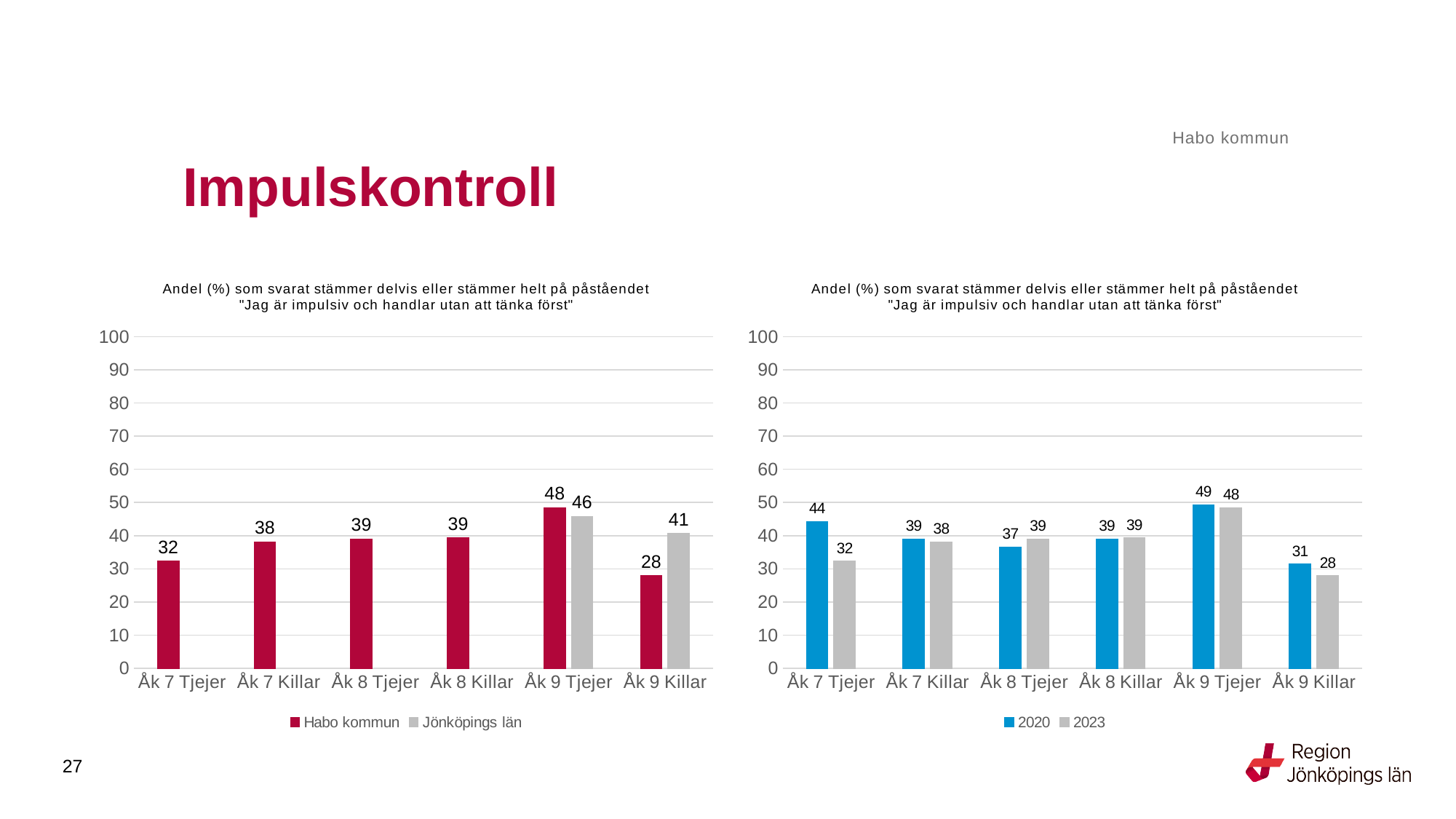
In the left chart, what is the difference between Habo kommun and Jönköpings län for Åk 9 Killar? 13 In the left chart, how many series does the legend list? 2 What type of chart is the left chart? Bar chart In the left chart, what is the value for Jönköpings län for Åk 9 Killar? 41 In the right chart, what is the 2020 value for Åk 7 Tjejer? 44 In the left chart, what is the value for Habo kommun for Åk 9 Tjejer? 48 In the right chart, what is the difference between the 2020 and 2023 values for Åk 7 Tjejer? 12 How many categories are shown on the x axis of the right chart? 6 In the right chart, which category has the highest 2020 value? Åk 9 Tjejer In the left chart, which category has the lowest Habo kommun value? Åk 9 Killar In the right chart, what is the 2023 value for Åk 9 Killar? 28 In the right chart, which is larger for Åk 8 Tjejer: the 2020 value or the 2023 value? 2023